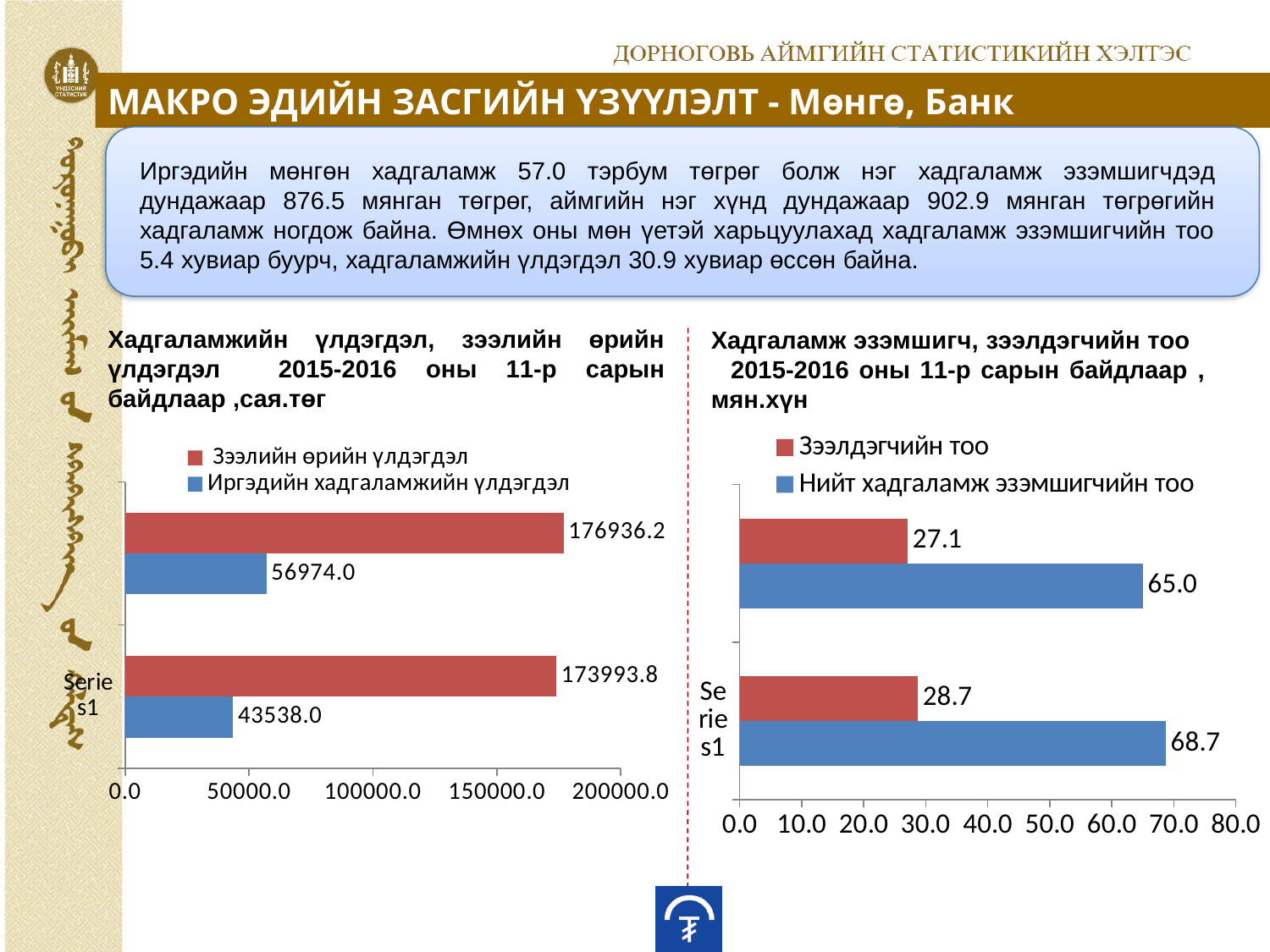
In the right chart, what is the value of the 'Зээлдэгчийн тоо' bar in the bottom group? 28.7 In the right chart, what is the difference between the two 'Нийт хадгаламж эзэмшигчийн тоо' bars (68.7 and 65.0)? 3.7 In the left chart, what is the value of the 'Зээлийн өрийн үлдэгдэл' bar in the top group? 176936.2 In the right chart titled 'Хадгаламж эзэмшигч, зээлдэгчийн тоо', what is the value of the 'Нийт хадгаламж эзэмшигчийн тоо' bar in the top group? 65.0 In the left chart, what is the difference between the two 'Иргэдийн хадгаламжийн үлдэгдэл' bars (56974.0 and 43538.0)? 13436.0 In the left chart, is the value 56974.0 greater or less than 50000.0 on the axis? greater In the left chart, which series has the larger value in the top group: 'Зээлийн өрийн үлдэгдэл' or 'Иргэдийн хадгаламжийн үлдэгдэл'? Зээлийн өрийн үлдэгдэл In the right chart, which bar has the lowest value? 27.1 In the left chart, what is the value of the 'Иргэдийн хадгаламжийн үлдэгдэл' bar in the bottom group? 43538.0 In the right chart, what colour are the 'Зээлдэгчийн тоо' bars? red How many series does the legend of the left chart list? 2 What type of chart is the left chart titled 'Хадгаламжийн үлдэгдэл, зээлийн өрийн үлдэгдэл'? bar chart